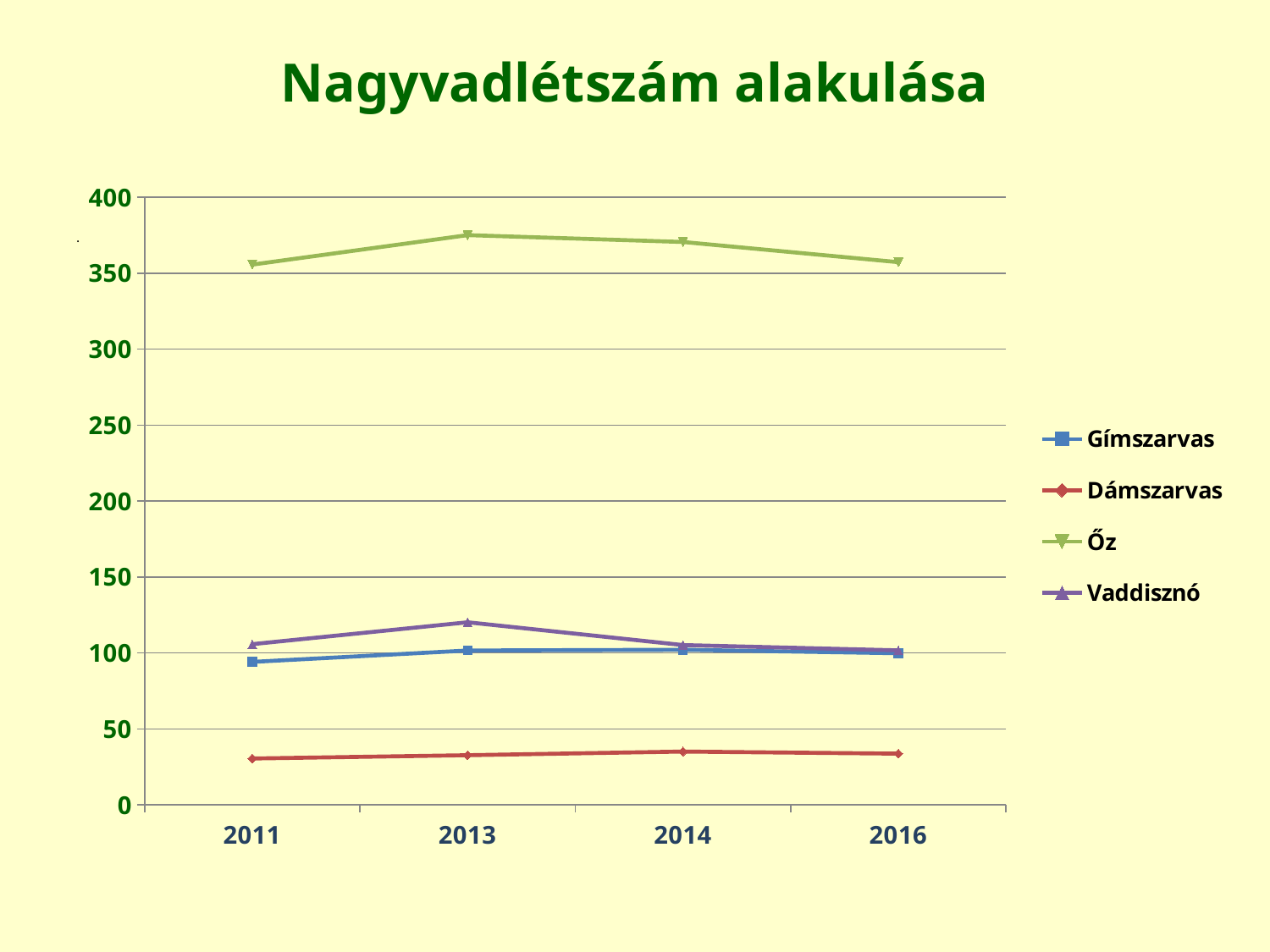
In 2013, which is larger: Vaddisznó or Gímszarvas? Vaddisznó In which year does Vaddisznó reach its highest value? 2013 What is the title of the chart? Nagyvadlétszám alakulása Is the value for Őz in 2013 greater or less than 350? greater Does the Dámszarvas line rise or fall from 2011 to 2014? rise How many years are shown on the x axis? 4 What kind of chart is shown on the slide? line chart Is the value for Vaddisznó in 2013 greater or less than 100? greater Which series has the lowest value in 2016? Dámszarvas Which series has the highest value in 2013? Őz How many series does the legend list? 4 Is the value for Dámszarvas in 2014 greater or less than 50? less